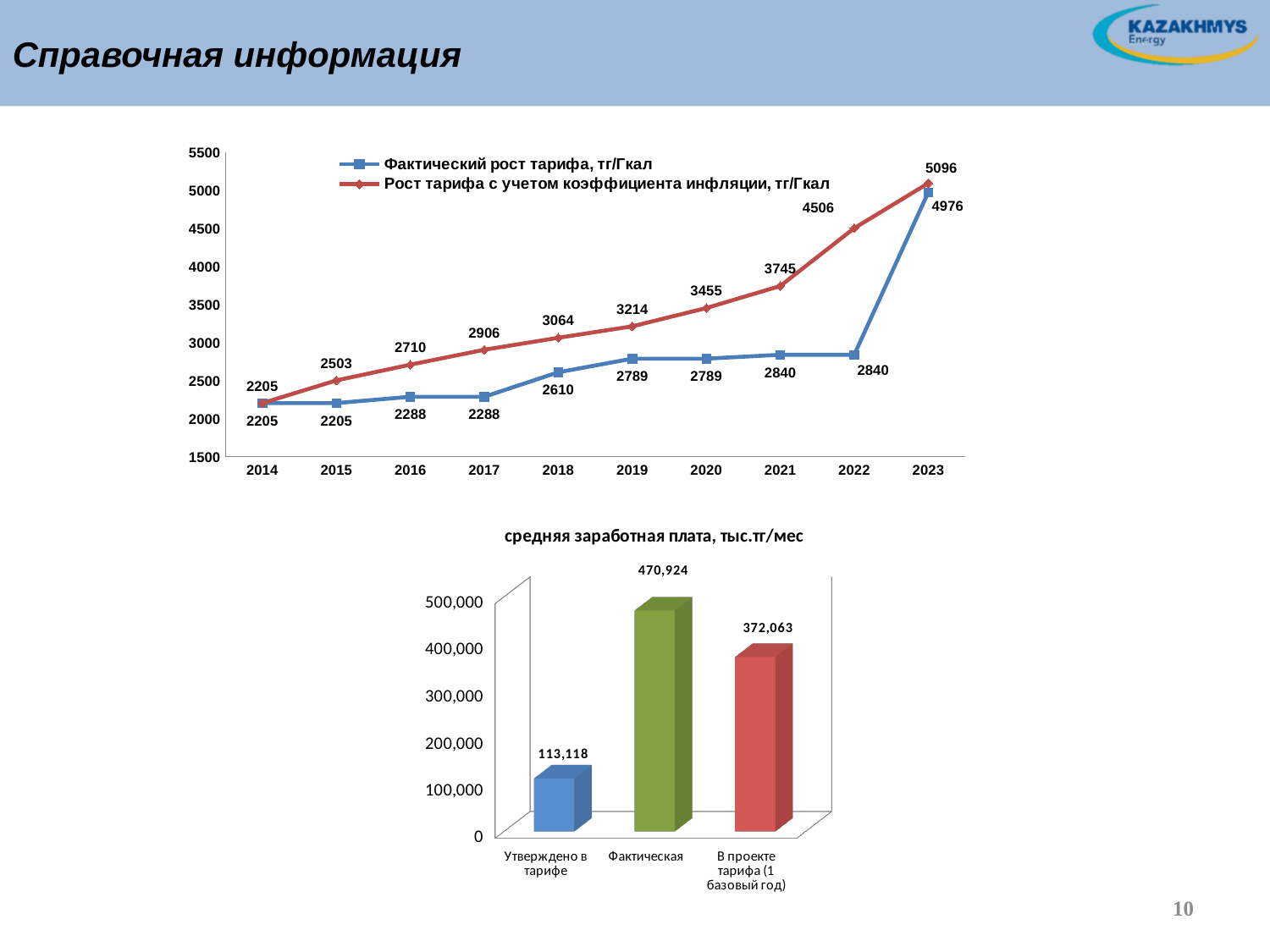
In the top line chart, does the 'Рост тарифа с учетом коэффициента инфляции' series rise or fall from 2014 to 2023? rise In the top line chart, how many years are shown on the x axis? 10 What type of chart is the bottom chart titled 'средняя заработная плата, тыс.тг/мес'? bar chart In the top line chart, in which year does 'Фактический рост тарифа' reach its highest value? 2023 In the bottom bar chart, which category has the lowest value? Утверждено в тарифе In the bottom bar chart, what is the value for 'Фактическая'? 470,924 In the top line chart, which series has the higher value in 2022? Рост тарифа с учетом коэффициента инфляции, тг/Гкал In the top line chart, what is the difference between the two series in 2023? 120 In the bottom bar chart, what is the difference between 'Фактическая' and 'В проекте тарифа (1 базовый год)'? 98,861 In the top line chart, how many series does the legend list? 2 In the top line chart, what is the value of 'Фактический рост тарифа, тг/Гкал' in 2018? 2610 In the top line chart, what is the value of 'Рост тарифа с учетом коэффициента инфляции, тг/Гкал' in 2021? 3745